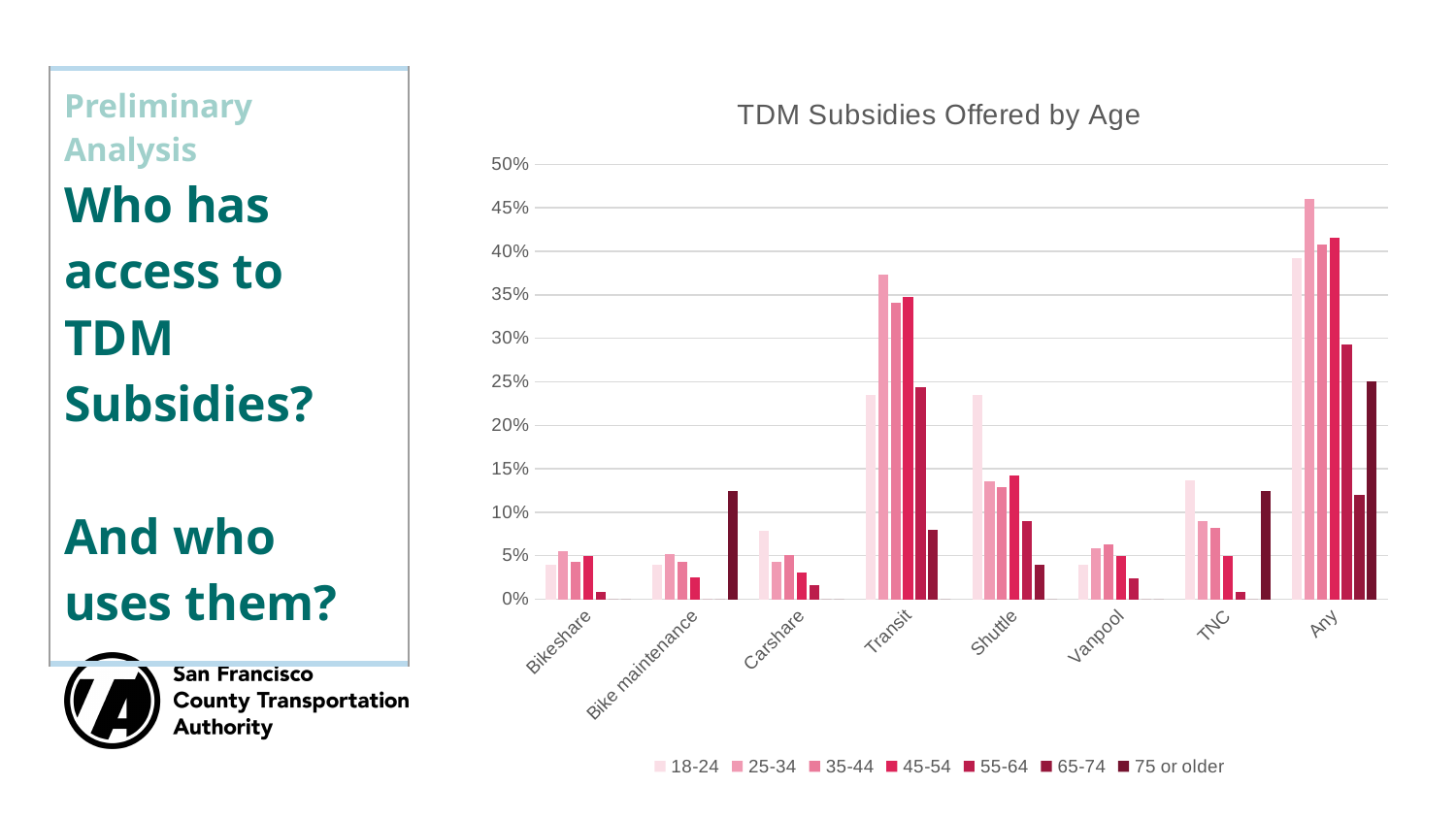
Which subsidy category has the tallest bar overall? Any For the 18-24 age group, which is larger: the value for Carshare or the value for Bikeshare? Carshare How many subsidy categories are shown on the x axis? 8 Is the value for the 18-24 age group in the Shuttle category greater or less than 20%? greater Is the value for the 25-34 age group in the Transit category greater or less than 35%? greater Within the Transit category, which age group has the highest value? 25-34 What type of chart is shown on the slide? bar chart Is the value for the 25-34 age group in the Any category greater or less than 40%? greater How many age groups does the legend list? 7 In the Any category, which is larger: the value for 18-24 or the value for 55-64? 18-24 What is the title of the chart? TDM Subsidies Offered by Age